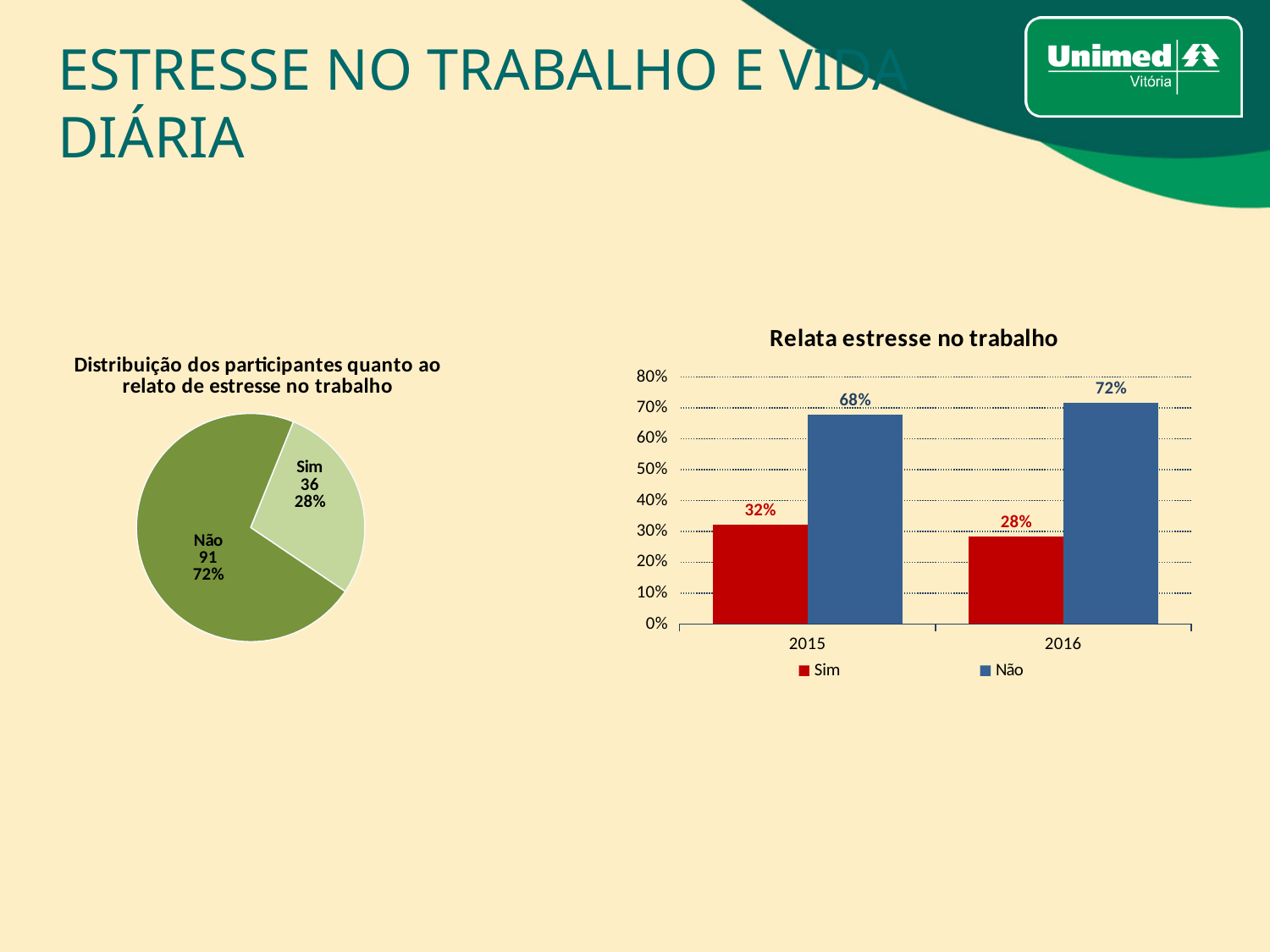
What kind of chart is 'Relata estresse no trabalho'? bar chart In the bar chart 'Relata estresse no trabalho', what is the difference between 'Não' and 'Sim' in 2016? 44% In the pie chart 'Distribuição dos participantes quanto ao relato de estresse no trabalho', how many slices are there? 2 In the bar chart 'Relata estresse no trabalho', how many series does the legend list? 2 In the pie chart 'Distribuição dos participantes quanto ao relato de estresse no trabalho', what is the difference in participant count between 'Não' and 'Sim'? 55 In the bar chart 'Relata estresse no trabalho', what is the value for 'Não' in 2016? 72% In the bar chart 'Relata estresse no trabalho', does the value for 'Sim' rise or fall from 2015 to 2016? fall In the bar chart 'Relata estresse no trabalho', what is the value for 'Sim' in 2015? 32% In the bar chart 'Relata estresse no trabalho', what colour are the 'Sim' bars? red In the pie chart 'Distribuição dos participantes quanto ao relato de estresse no trabalho', what percentage of participants answered 'Não'? 72% In the pie chart 'Distribuição dos participantes quanto ao relato de estresse no trabalho', which slice is the largest? Não In the pie chart 'Distribuição dos participantes quanto ao relato de estresse no trabalho', how many participants answered 'Sim'? 36